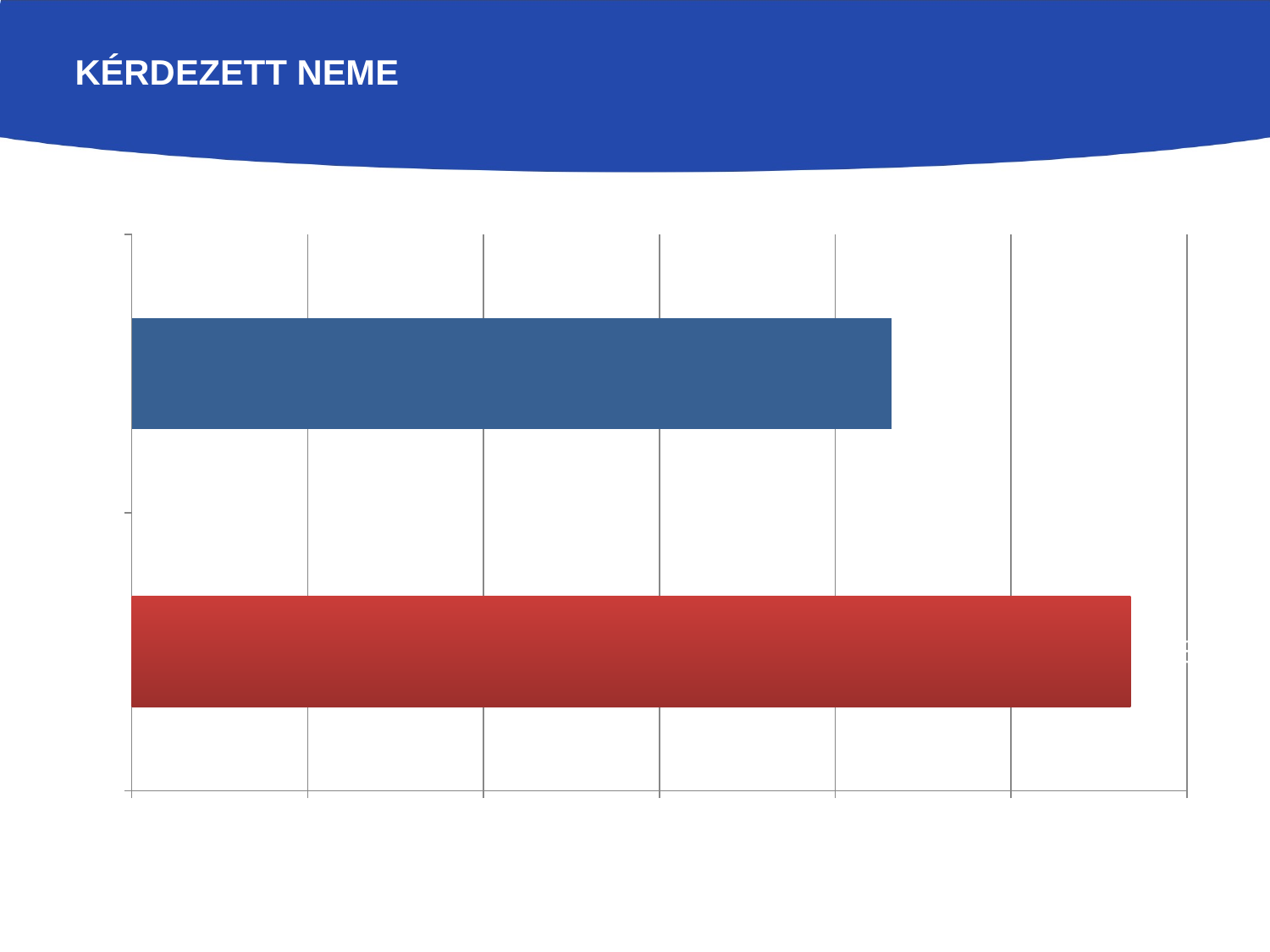
Which bar represents the highest value in the chart? the red (bottom) bar How many bars are plotted in the chart? 2 Which bar is longer, the blue (top) bar or the red (bottom) bar? the red (bottom) bar What is the title shown at the top of the slide? KÉRDEZETT NEME Which bar represents the lowest value in the chart? the blue (top) bar Are the bars in the chart drawn horizontally or vertically? horizontally What kind of chart is shown on the slide? bar chart